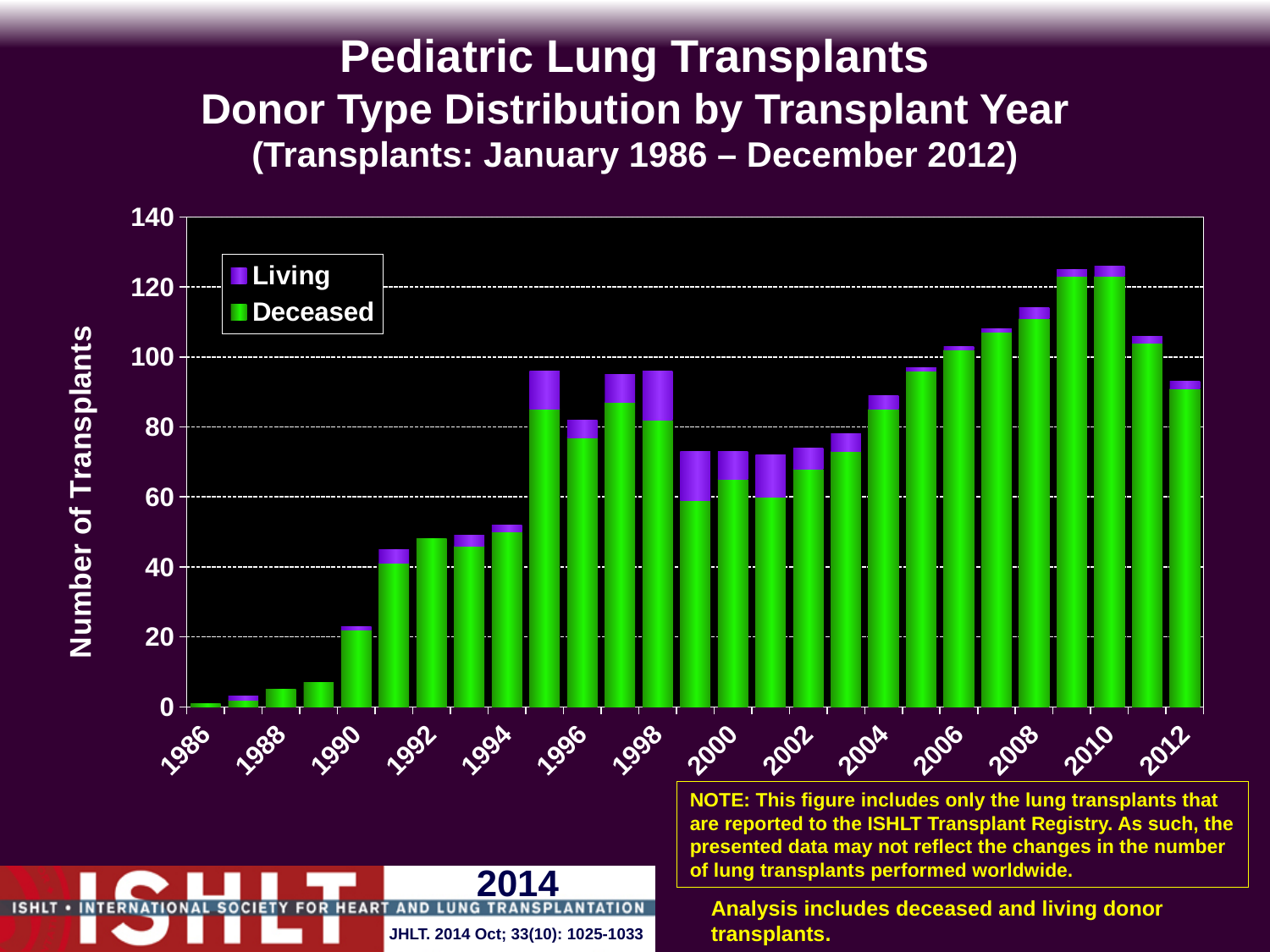
Which year has the lowest total number of transplants? 1986 Which year has a higher total number of transplants, 2000 or 2004? 2004 How many transplant years (bars) are plotted on the chart? 27 Is the total number of transplants for 1989 greater or less than 20? less Is the total number of transplants for 2012 greater or less than 100? less Is the total number of transplants for 2010 greater or less than 120? greater What kind of chart is shown on the slide? Stacked bar chart Do the total transplant numbers rise or fall from 2003 to 2009? rise How many series does the legend list? 2 Which year has a higher total number of transplants, 1996 or 1997? 1997 What are the two donor types shown in the legend? Living and Deceased